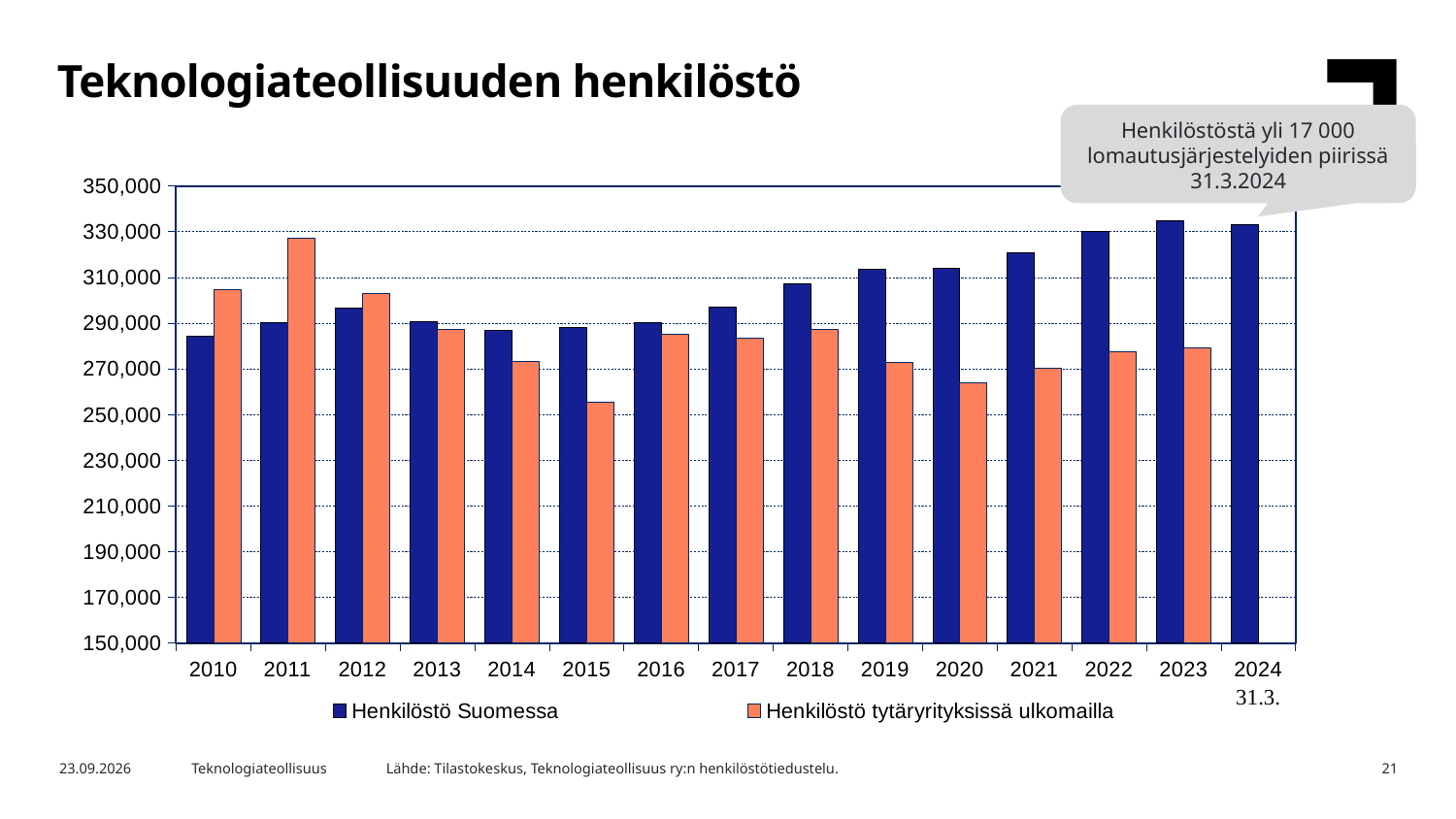
Which year has the highest value for Henkilöstö tytäryrityksissä ulkomailla? 2011 Does Henkilöstö Suomessa rise or fall from 2016 to 2023? rise Which year has the lowest value for Henkilöstö tytäryrityksissä ulkomailla? 2015 Is the value for Henkilöstö tytäryrityksissä ulkomailla in 2015 greater or less than 270,000? less In 2010, which is larger: Henkilöstö Suomessa or Henkilöstö tytäryrityksissä ulkomailla? Henkilöstö tytäryrityksissä ulkomailla Is the value for Henkilöstö tytäryrityksissä ulkomailla in 2011 greater or less than 310,000? greater How many years are shown on the x axis? 15 What is the title of the chart? Teknologiateollisuuden henkilöstö Is the value for Henkilöstö Suomessa in 2022 greater or less than 310,000? greater How many series does the legend list? 2 What kind of chart is shown on the slide? bar chart In 2023, which is larger: Henkilöstö Suomessa or Henkilöstö tytäryrityksissä ulkomailla? Henkilöstö Suomessa